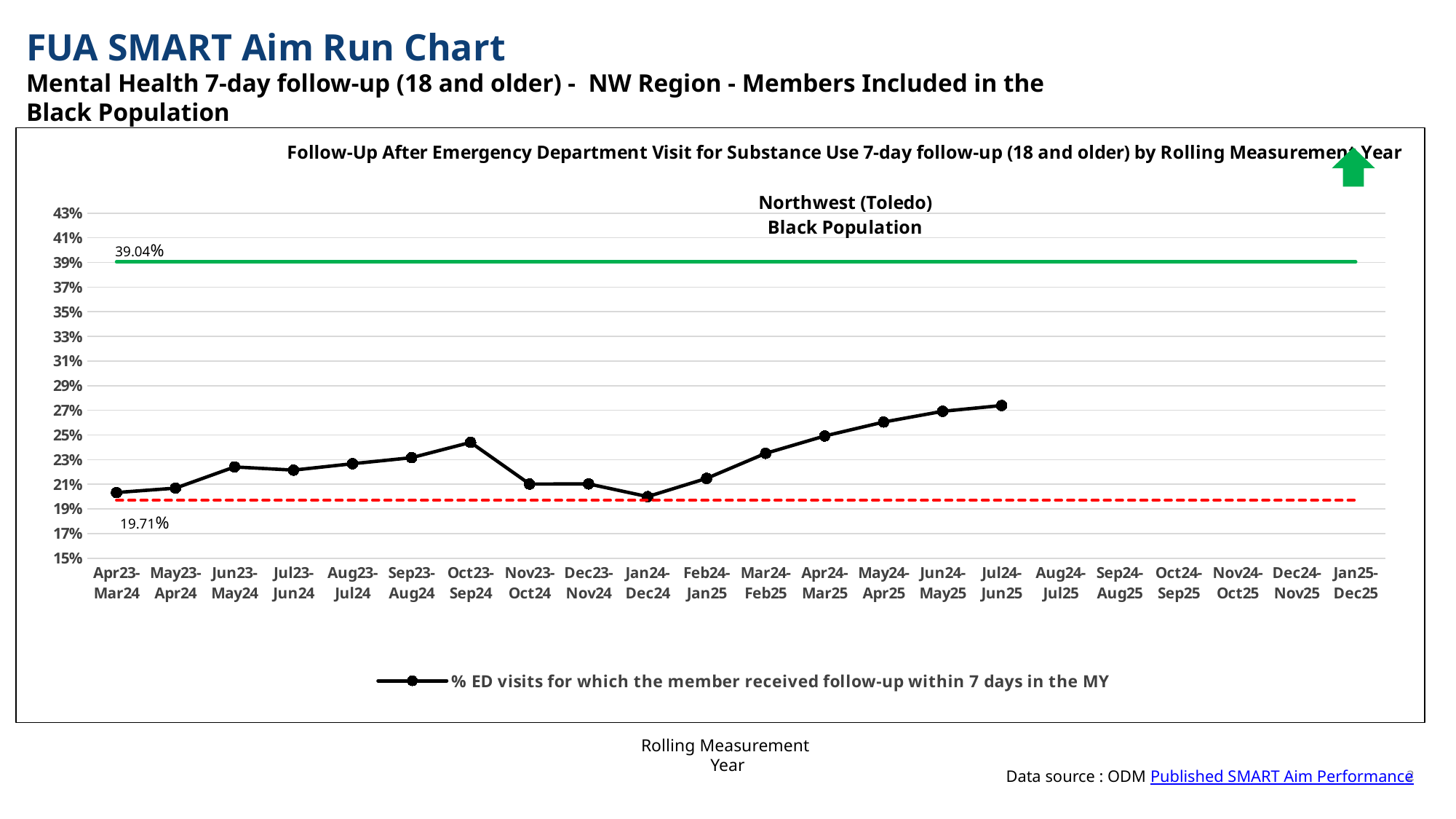
How many rolling measurement year categories are shown on the x axis? 22 How many data points are plotted on the line? 16 Which rolling measurement year has the highest plotted value? Jul24-Jun25 What kind of chart is shown on the slide? line chart Is the value for Jan24-Dec24 greater or less than 21%? less What value is labelled on the red dashed horizontal line? 19.71% Which is higher, the value for Oct23-Sep24 or the value for Nov23-Oct24? Oct23-Sep24 What is the legend entry for the plotted line? % ED visits for which the member received follow-up within 7 days in the MY Is the value for Jul24-Jun25 greater or less than 25%? greater Do the plotted values rise or fall from Jan24-Dec24 to Jul24-Jun25? rise What value is labelled on the solid green horizontal line? 39.04% How many series does the legend list? 1